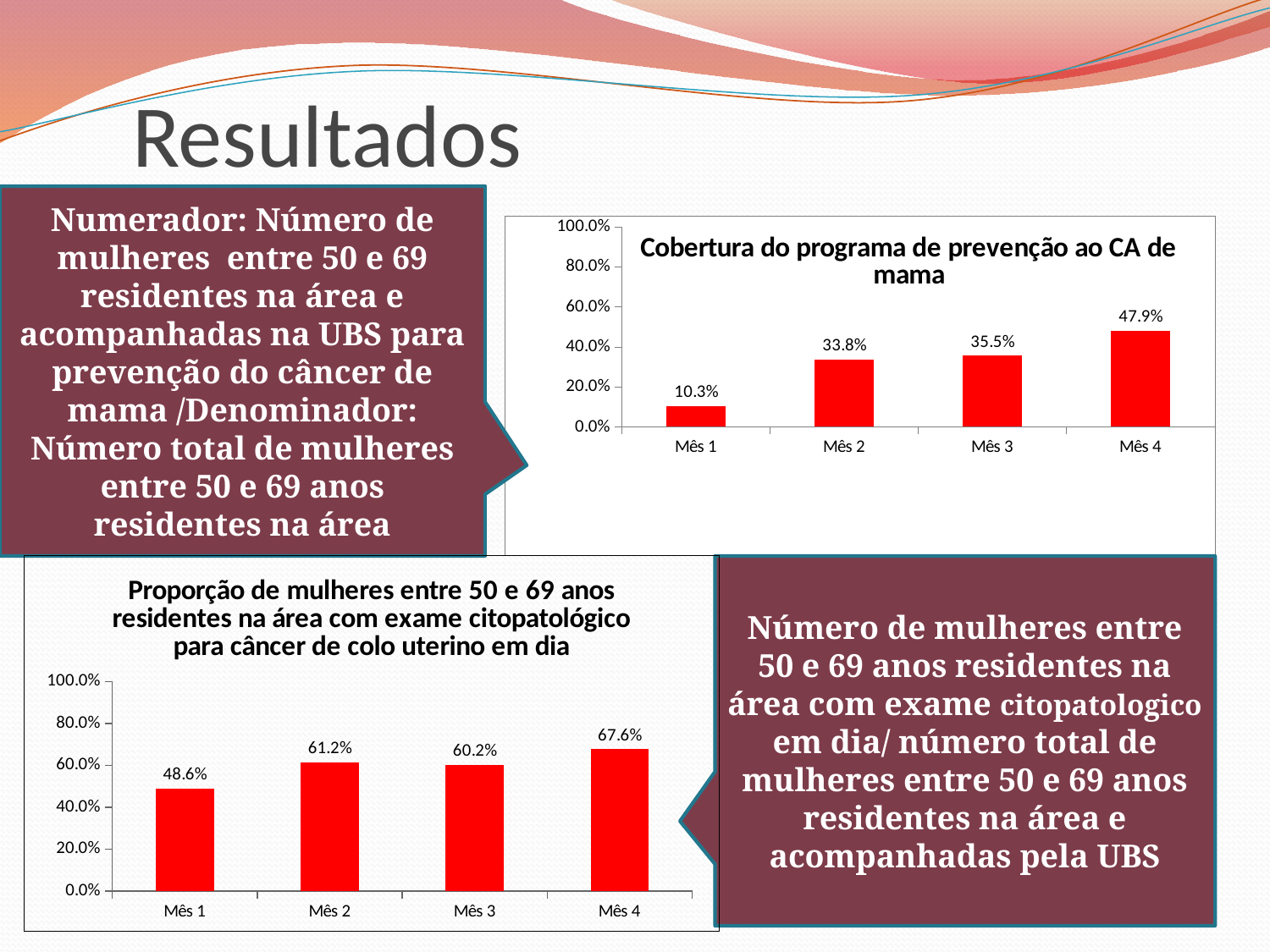
In the bottom-left chart 'Proporção de mulheres entre 50 e 69 anos residentes na área com exame citopatológico para câncer de colo uterino em dia', what is the difference between Mês 4 and Mês 1? 19.0% In the bottom-left chart 'Proporção de mulheres entre 50 e 69 anos residentes na área com exame citopatológico para câncer de colo uterino em dia', which month has the lowest value? Mês 1 In the chart 'Cobertura do programa de prevenção ao CA de mama', how many months are plotted? 4 In the chart 'Cobertura do programa de prevenção ao CA de mama', what is the value for Mês 1? 10.3% In the chart 'Cobertura do programa de prevenção ao CA de mama', which month has the highest value? Mês 4 What colour are the bars in the chart 'Cobertura do programa de prevenção ao CA de mama'? red In the chart 'Cobertura do programa de prevenção ao CA de mama', what is the value for Mês 4? 47.9% In the chart 'Cobertura do programa de prevenção ao CA de mama', do the values rise or fall from Mês 1 to Mês 4? rise In the bottom-left chart 'Proporção de mulheres entre 50 e 69 anos residentes na área com exame citopatológico para câncer de colo uterino em dia', which is larger, Mês 2 or Mês 3? Mês 2 What kind of chart is the bottom-left chart 'Proporção de mulheres entre 50 e 69 anos residentes na área com exame citopatológico para câncer de colo uterino em dia'? bar chart In the bottom-left chart 'Proporção de mulheres entre 50 e 69 anos residentes na área com exame citopatológico para câncer de colo uterino em dia', what is the value for Mês 2? 61.2% In the chart 'Cobertura do programa de prevenção ao CA de mama', what is the difference between Mês 4 and Mês 1? 37.6%